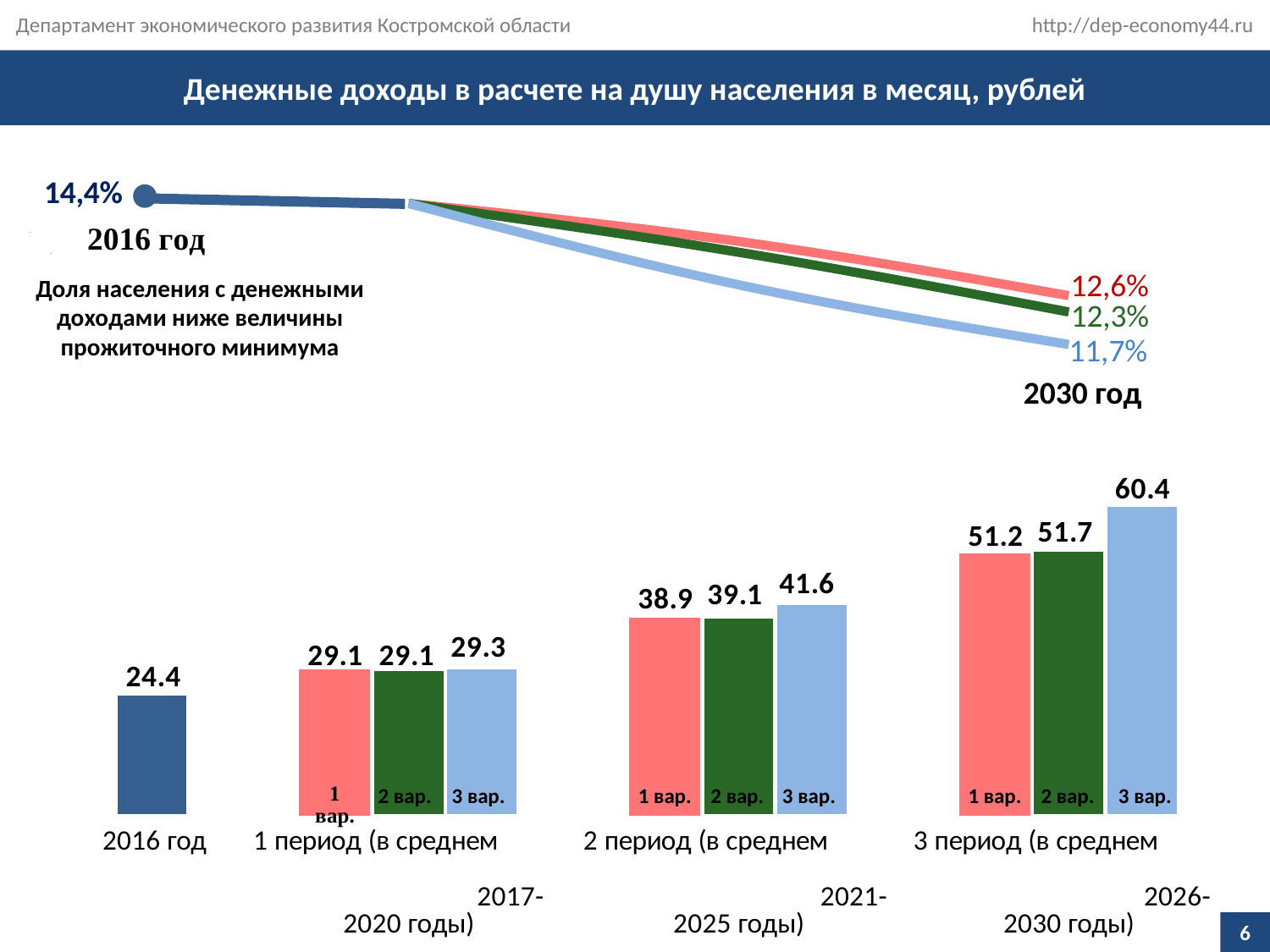
In the bar chart at the bottom of the slide, how many bars are plotted in total? 10 In the bar chart at the bottom of the slide, what is the value for 2016 год? 24.4 In the top chart showing the share of population with incomes below the subsistence minimum, what is the lowest value shown for 2030 год? 11,7% In the bar chart at the bottom of the slide, what is the value for 3 вар. in 3 период (2026-2030 годы)? 60.4 In the bar chart at the bottom of the slide, do the values for 3 вар. rise or fall from 1 период to 3 период? rise In the bar chart at the bottom of the slide, which is larger: 2 вар. in 2 период or 3 вар. in 2 период? 3 вар. in 2 период In the bar chart at the bottom of the slide, which bar has the highest value? 3 вар. in 3 период (2026-2030 годы) What kind of chart is shown at the bottom of the slide? bar chart In the bar chart at the bottom of the slide, what is the difference between 3 вар. and 1 вар. in 3 период (2026-2030 годы)? 9.2 In the bar chart at the bottom of the slide, what is the value for 1 вар. in 2 период (2021-2025 годы)? 38.9 In the bar chart at the bottom of the slide, which bar has the lowest value? 2016 год In the top chart showing the share of population with incomes below the subsistence minimum, what is the value for 2016 год? 14,4%